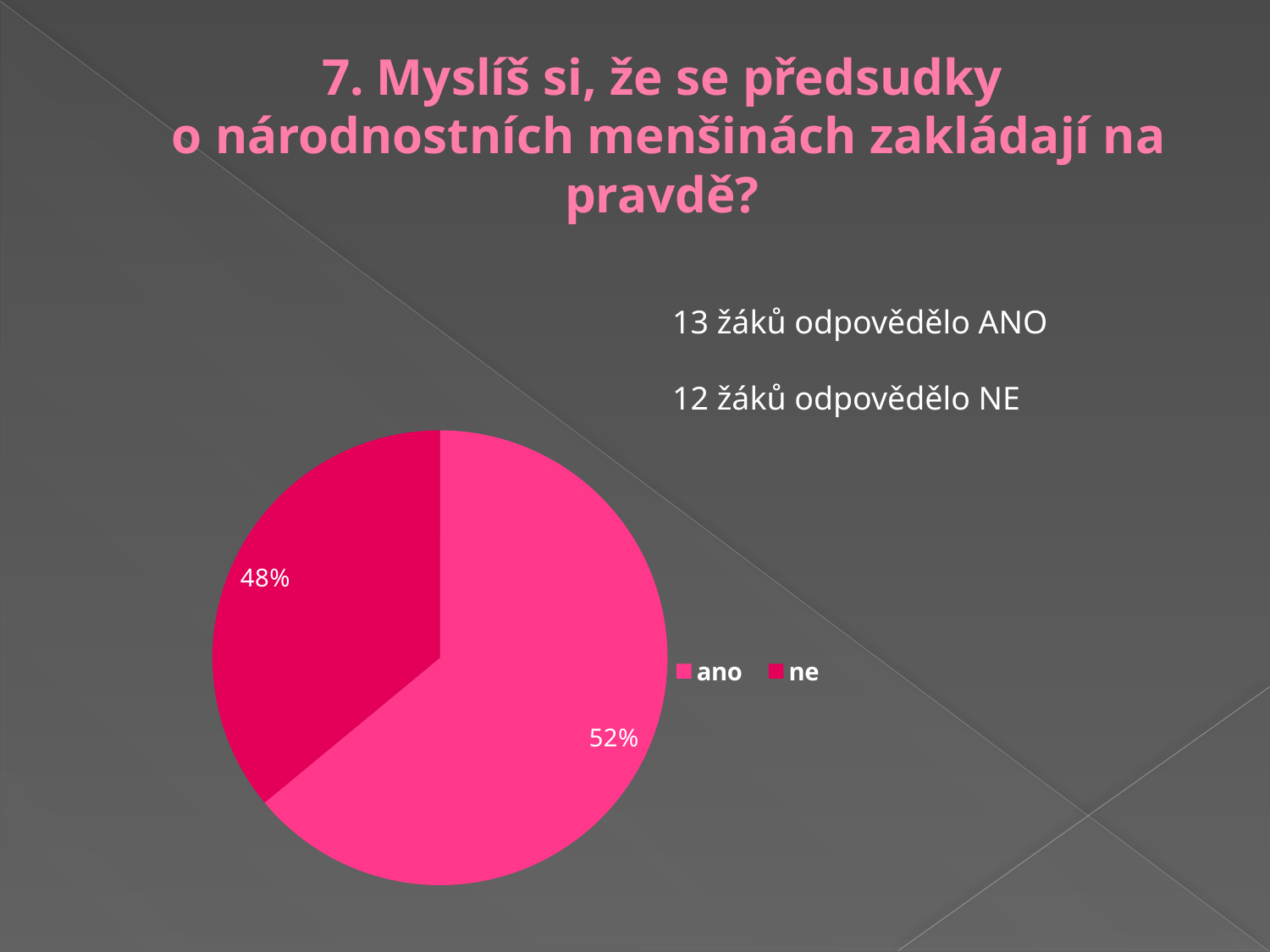
How many entries does the legend list? 2 Which legend entry is shown in the darker pink colour? ne What percentage of the pie does the "ne" slice represent? 48% Which slice is the largest in the pie chart? ano What is the difference in percentage points between the "ano" and "ne" slices? 4 Which slice is the smallest in the pie chart? ne Is the share of the "ano" slice greater or less than 50%? greater What are the two legend entries of the pie chart? ano, ne How many slices does the pie chart have? 2 What kind of chart is shown on the slide? pie chart What percentage of the pie does the "ano" slice represent? 52% Which slice is larger, "ano" or "ne"? ano